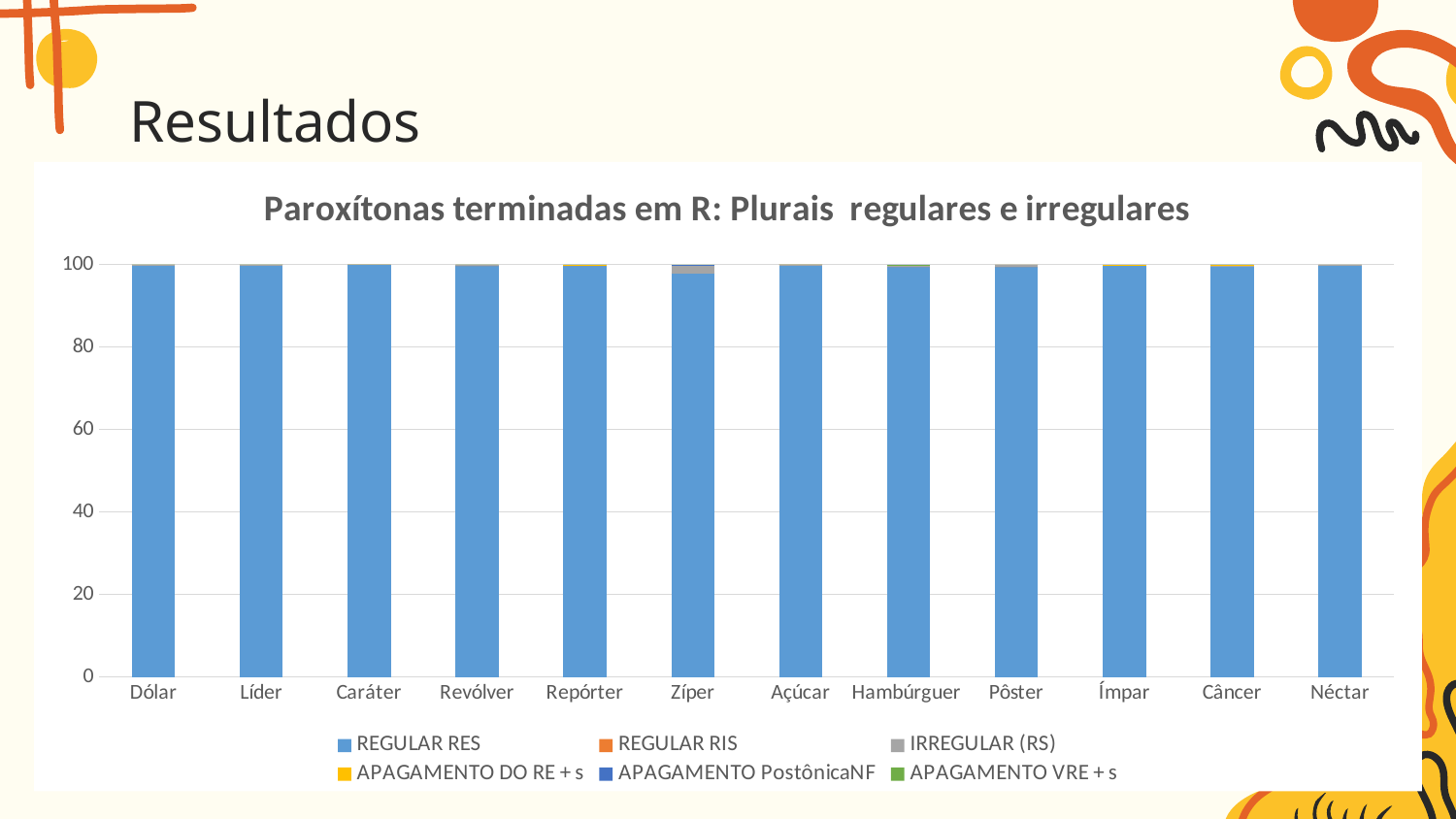
What is the highest value shown on the y axis of the chart? 100 Is the value of REGULAR RES for Zíper greater or less than 40? greater What is the total height of the stacked bar for Líder? 100 Is the value of REGULAR RES for Dólar greater or less than 80? greater What is the title of the chart? Paroxítonas terminadas em R: Plurais regulares e irregulares Which category shows the largest IRREGULAR (RS) segment? Zíper How many series does the chart's legend list? 6 How many categories (words) are shown along the x axis of the chart? 12 Is the value of REGULAR RES for Néctar greater or less than 60? greater What kind of chart is shown on the slide? bar chart Which series is shown in blue in the chart's legend? REGULAR RES